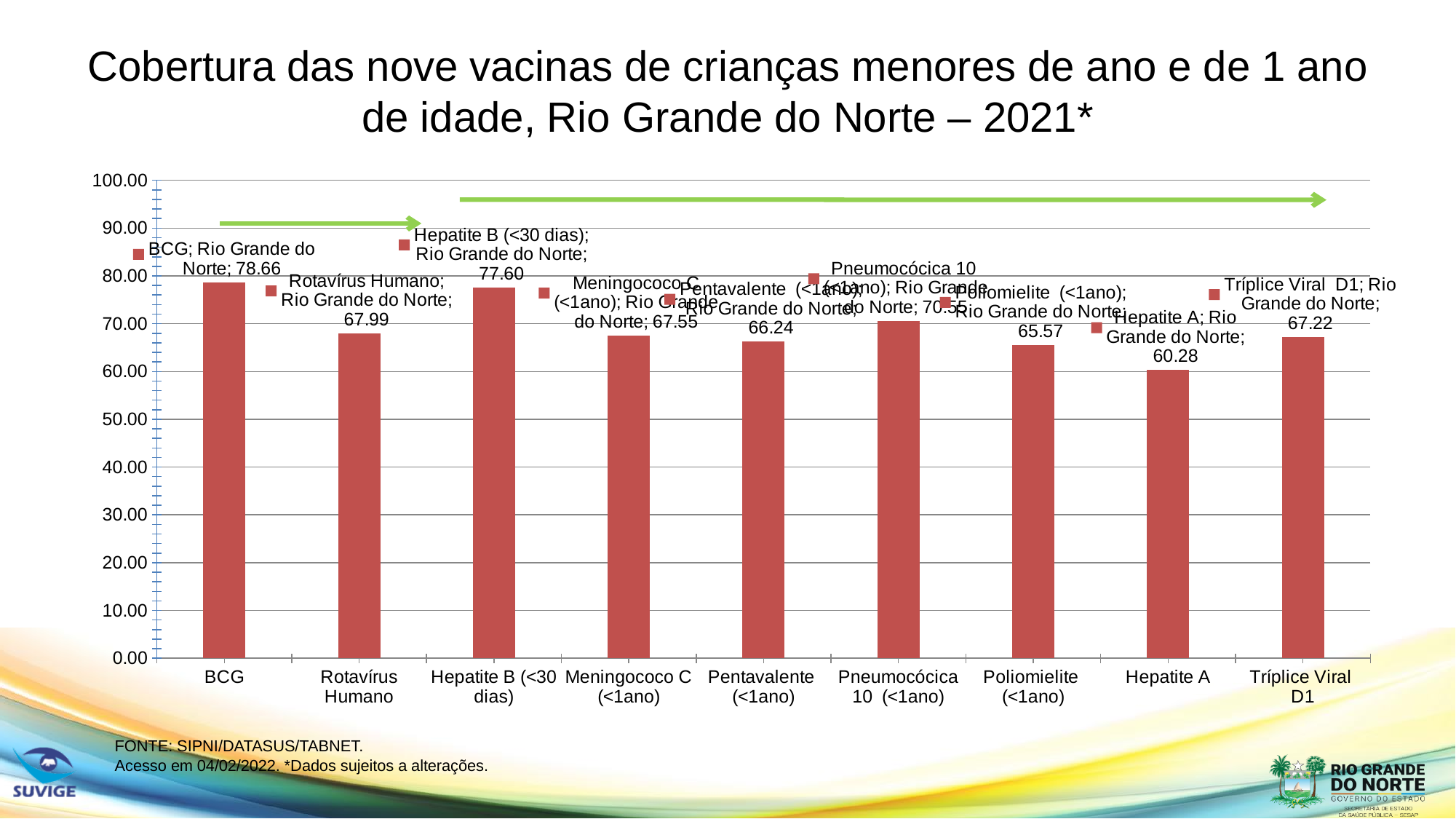
Is the value for Poliomielite (<1ano) greater or less than 70.00? less Which is larger, the value for Rotavírus Humano or the value for Pentavalente (<1ano)? Rotavírus Humano What is the value for Hepatite A? 60.28 What is the value for BCG? 78.66 What is the difference between the values for BCG and Hepatite A? 18.38 What is the value for Tríplice Viral D1? 67.22 Which vaccine has the lowest coverage value? Hepatite A What is the value for Pneumocócica 10 (<1ano)? 70.55 What is the data source cited below the chart? SIPNI/DATASUS/TABNET What kind of chart is shown on the slide? bar chart How many vaccines (categories) are shown on the x axis? 9 Which vaccine has the highest coverage value? BCG